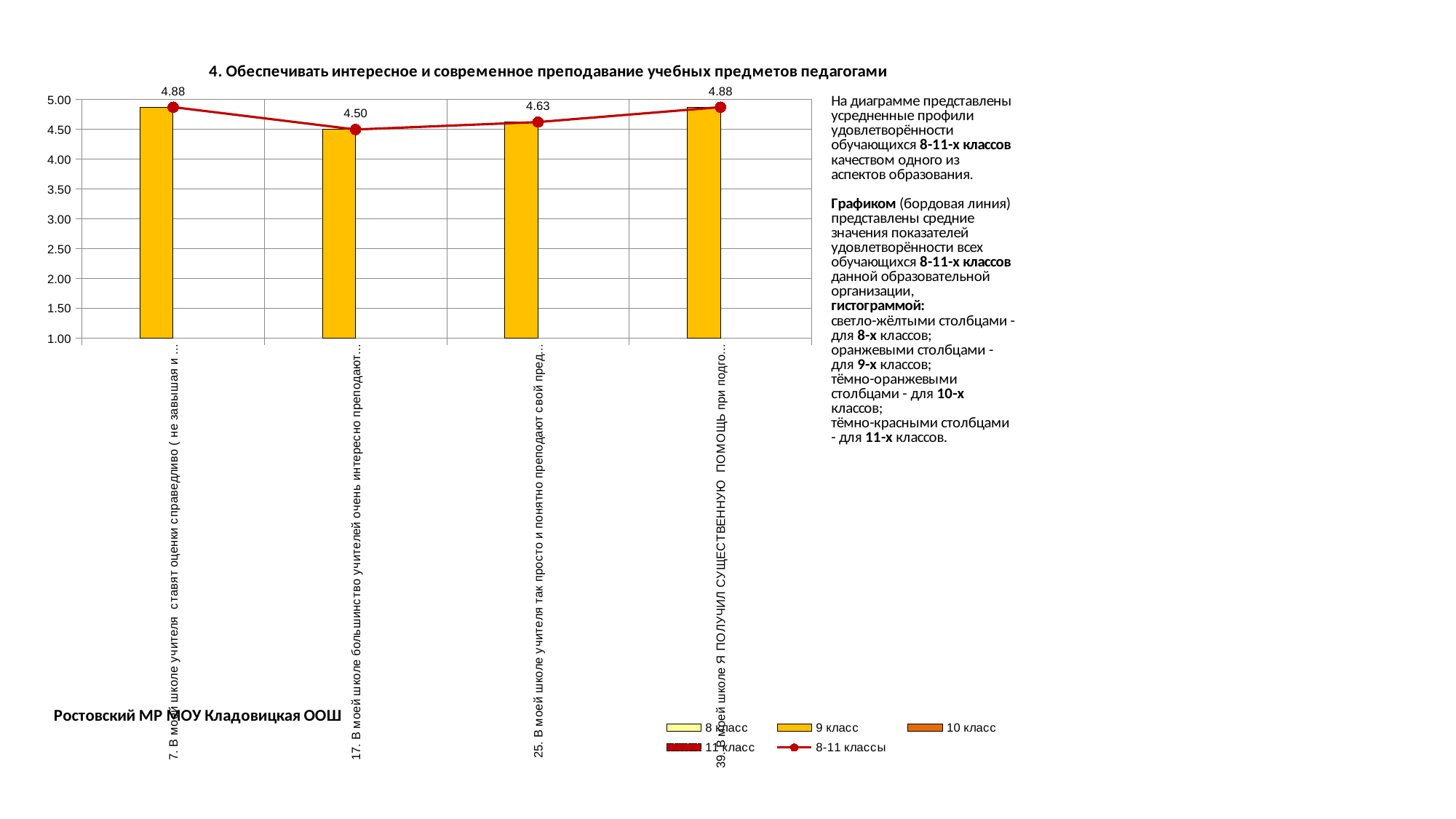
Which question has the lowest value on the 8-11 классы line? 17 What is the value of the 8-11 классы line for question 25 (В моей школе учителя так просто и понятно преподают свой предмет...)? 4.63 Does the 8-11 классы line rise or fall from question 17 to question 39? rises What is the difference between the 8-11 классы values for question 39 and question 17? 0.38 Is the value for question 17 greater or less than 4.00? greater How many series does the legend list? 5 What is the value of the 8-11 классы line for question 7 (В моей школе учителя ставят оценки справедливо...)? 4.88 What is the value of the 8-11 классы line for question 17 (В моей школе большинство учителей очень интересно преподают...)? 4.50 Which has the larger 8-11 классы value: question 17 or question 25? 25 What is the difference between the 8-11 классы values for question 25 and question 17? 0.13 What kind of chart is shown on the slide? bar chart with a line How many categories (questions) are shown on the x axis? 4